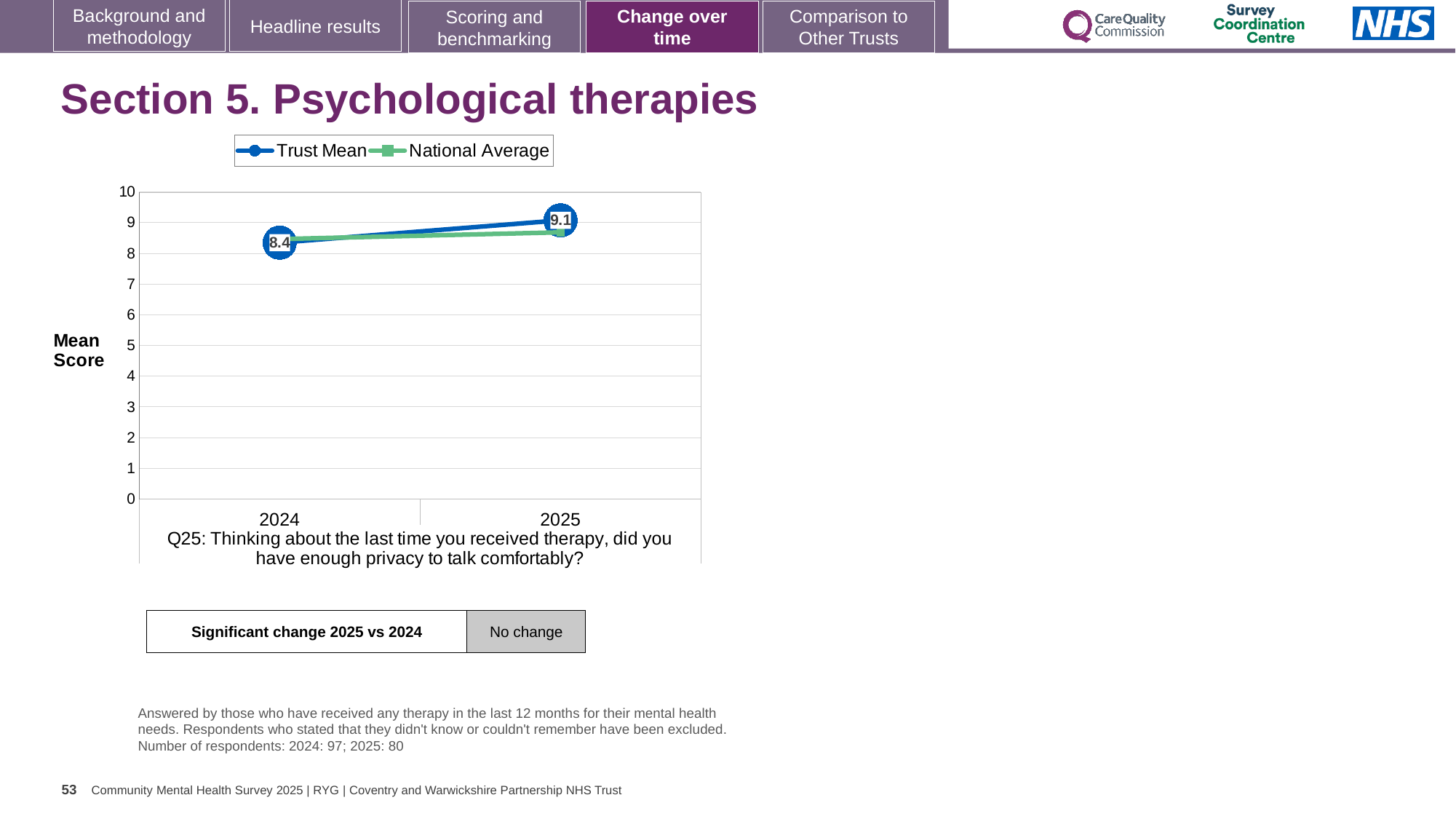
What is the Trust Mean score for 2025? 9.1 By how much did the Trust Mean score change from 2024 to 2025? 0.7 How many years are shown on the x axis of the chart? 2 In which year is the Trust Mean score lowest? 2024 Is the National Average value for 2024 greater or less than 9? less How many series does the chart legend list? 2 Is the National Average value for 2025 greater or less than 8? greater In which year is the Trust Mean score highest? 2025 What is the Trust Mean score for 2024? 8.4 In 2025, which is larger: the Trust Mean or the National Average? Trust Mean What kind of chart is shown on the slide? Line chart Does the Trust Mean rise or fall from 2024 to 2025? Rise